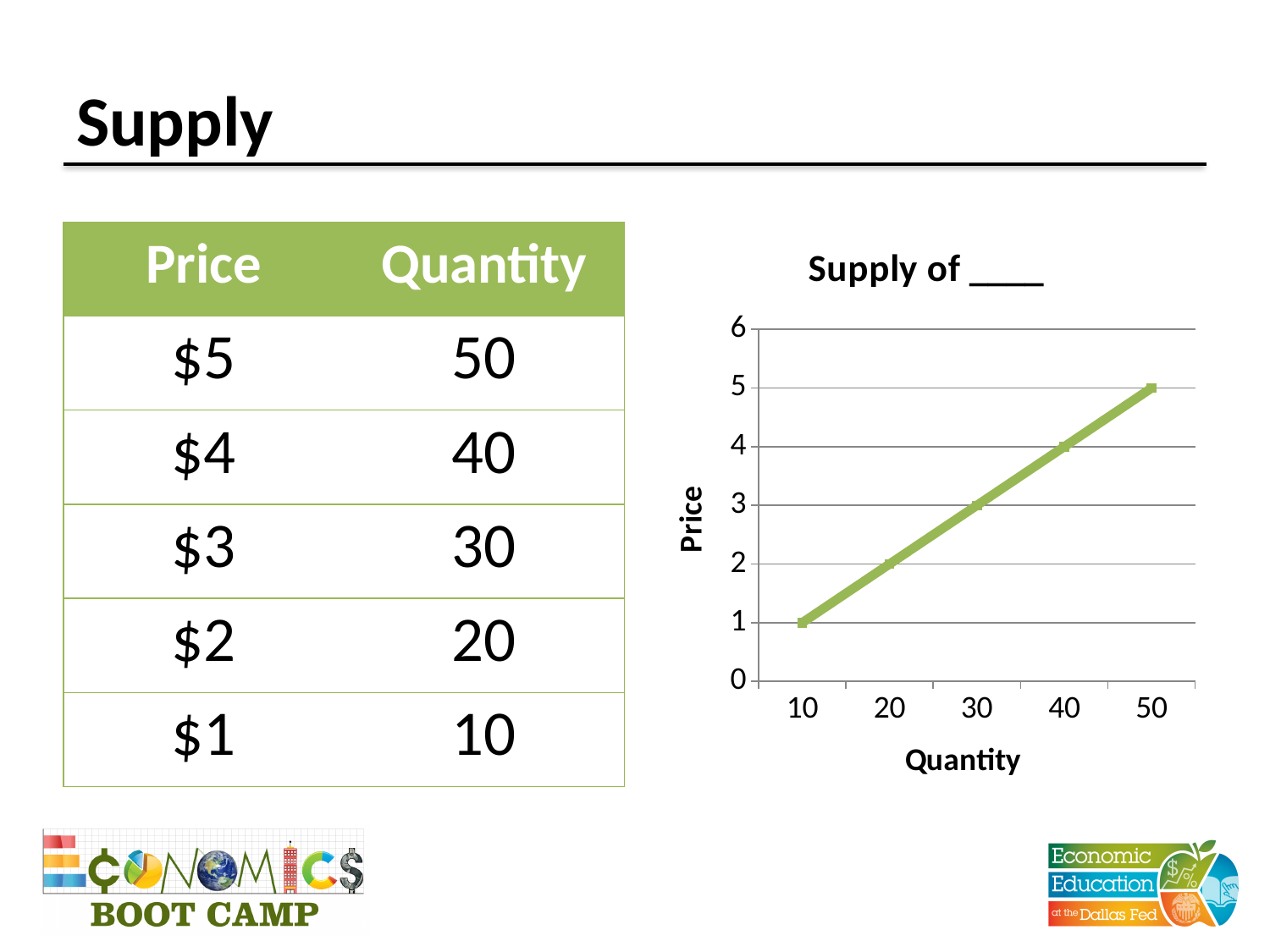
At which quantity is the price highest? 50 Which has the higher price: a quantity of 20 or a quantity of 40? 40 What is the price at a quantity of 10? 1 What is the label of the x axis of the chart? Quantity What is the price at a quantity of 30? 3 What is the price at a quantity of 50? 5 At which quantity is the price lowest? 10 What is the difference in price between a quantity of 40 and a quantity of 20? 2 What is the title of the chart? Supply of ____ Does the price rise or fall as quantity increases along the x axis? rise What kind of chart is shown on the slide? line chart How many data points are plotted on the line? 5